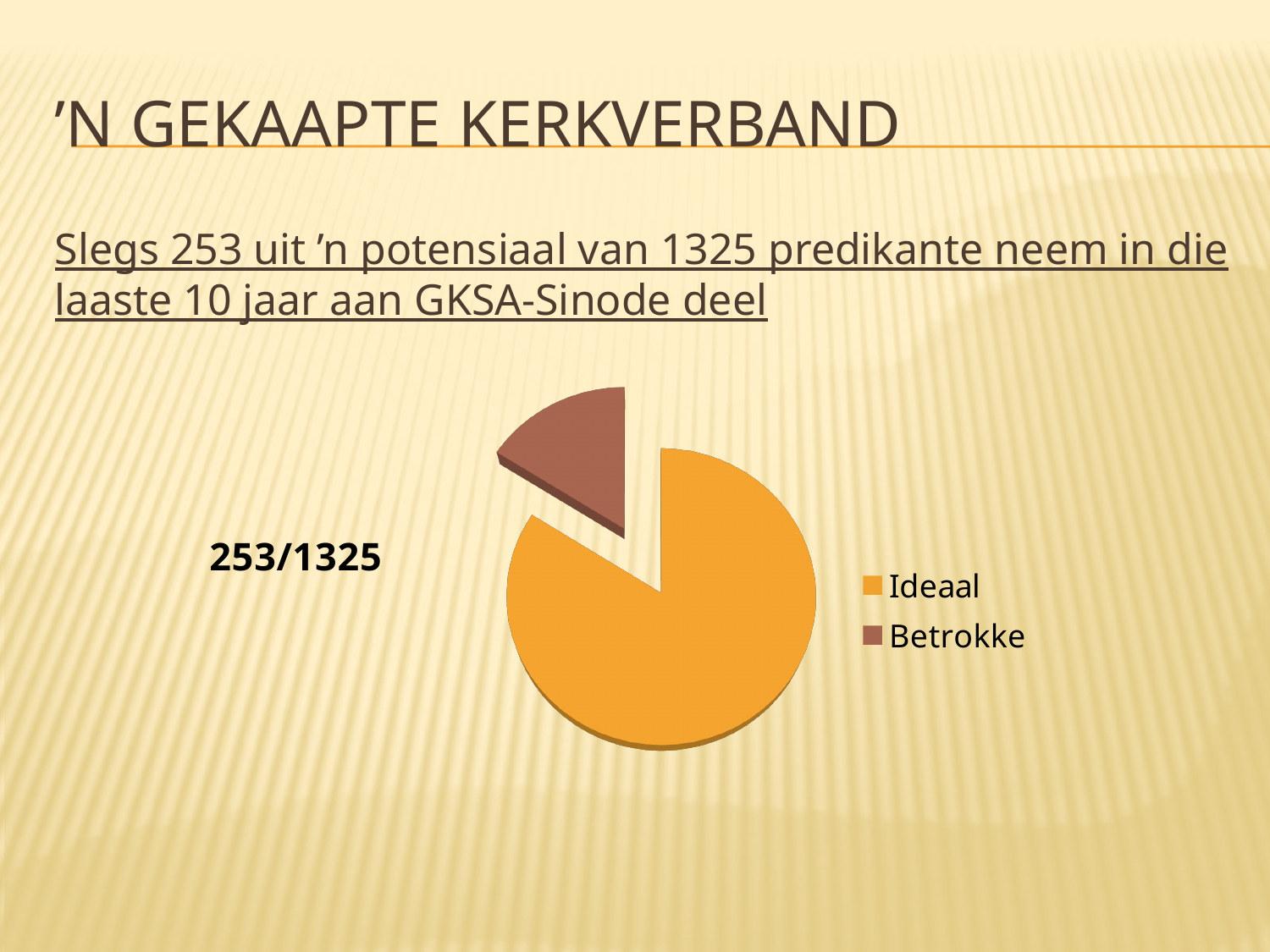
How many slices does the pie chart have? 2 Which slice of the pie chart is the smallest? Betrokke Which slice is larger in the pie chart, Ideaal or Betrokke? Ideaal Which slice of the pie chart is the largest? Ideaal What colour is the Ideaal slice in the pie chart? orange How many entries does the legend of the pie chart list? 2 Which slice of the pie chart is pulled out (exploded) from the rest of the pie? Betrokke What kind of chart is shown on the slide? pie chart